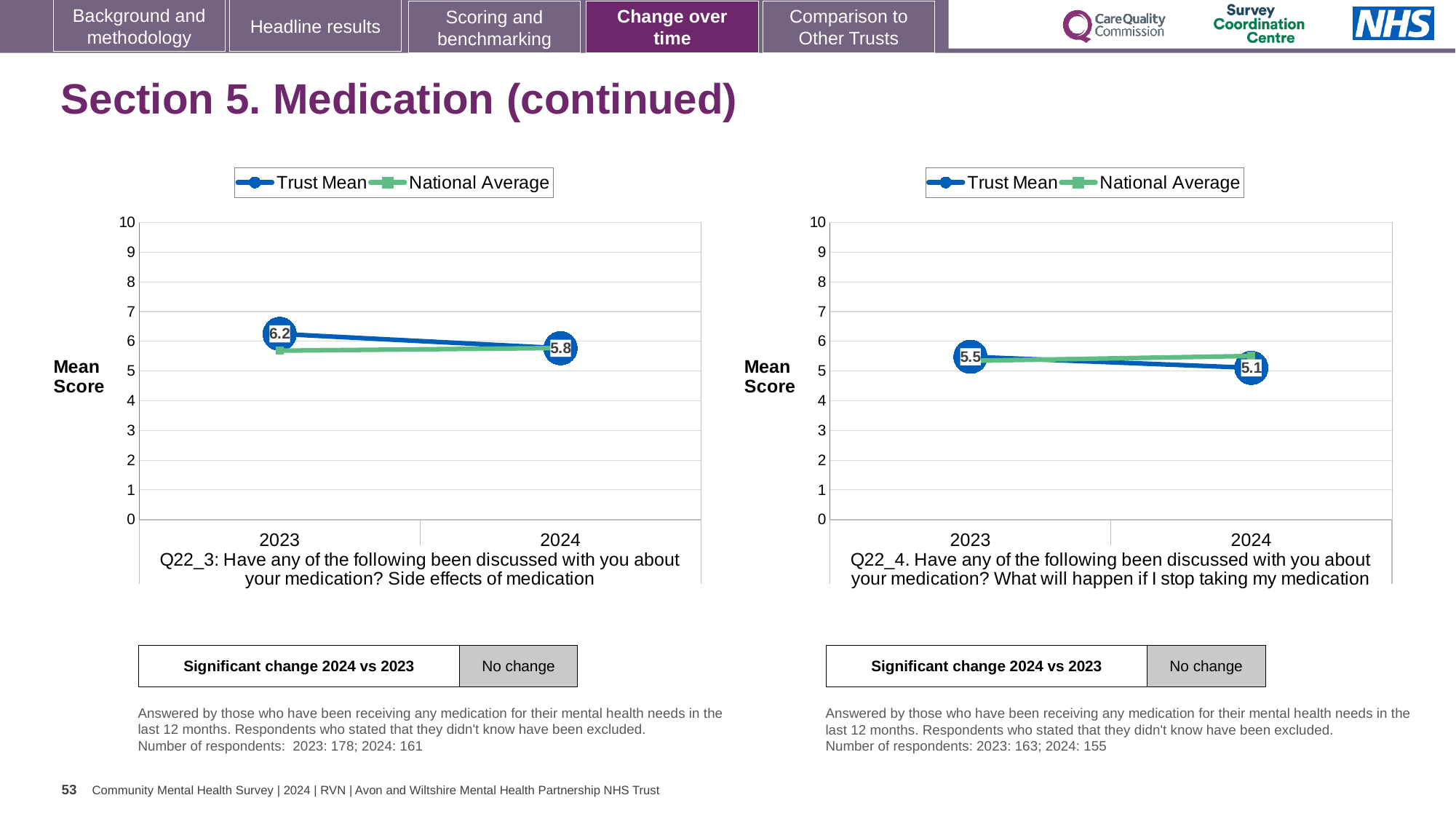
In the right chart (Q22_4), what is the Trust Mean for 2024? 5.1 In the left chart (Q22_3), by how much did the Trust Mean change from 2023 to 2024? 0.4 How many series does the legend of the left chart (Q22_3) list? 2 In the right chart (Q22_4), what is the Trust Mean for 2023? 5.5 In the left chart (Q22_3), is the National Average for 2023 greater or less than 5? greater In the right chart (Q22_4), what is the difference between the Trust Mean in 2023 and in 2024? 0.4 In the right chart (Q22_4), is the National Average for 2024 greater or less than 6? less In the left chart (Q22_3), what is the Trust Mean for 2024? 5.8 In the left chart (Q22_3), what is the Trust Mean for 2023? 6.2 In the right chart (Q22_4), which year has the higher Trust Mean, 2023 or 2024? 2023 What type of chart is the right chart (Q22_4)? line chart In the left chart (Q22_3), does the Trust Mean rise or fall from 2023 to 2024? fall